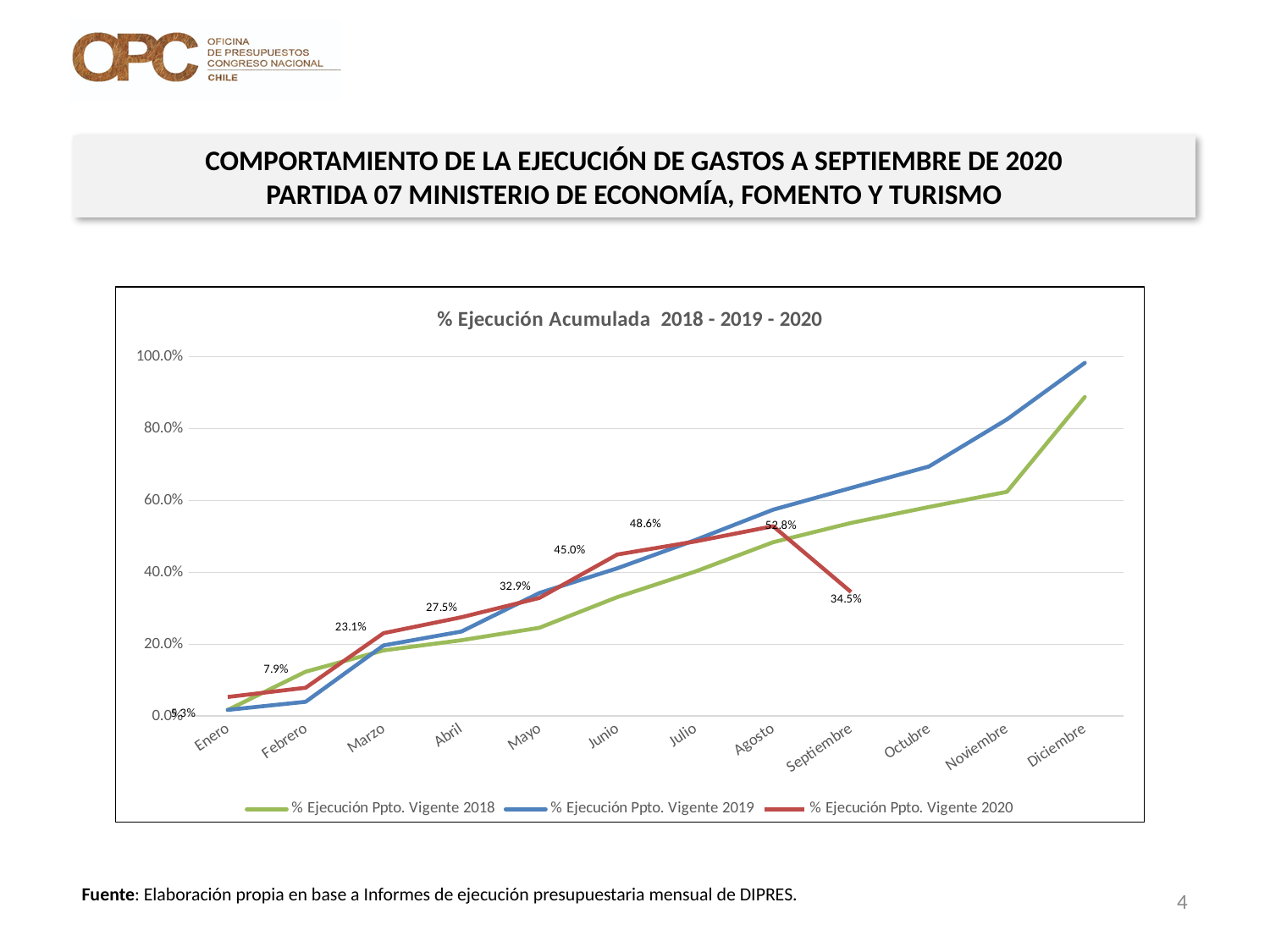
What is the difference between the Agosto and Julio values in the % Ejecución Ppto. Vigente 2020 series? 4.2% What is the value for Marzo in the % Ejecución Ppto. Vigente 2020 series? 23.1% In which month does the % Ejecución Ppto. Vigente 2020 series reach its highest value? Agosto What is the value for Septiembre in the % Ejecución Ppto. Vigente 2020 series? 34.5% Which series has the larger value in Diciembre, % Ejecución Ppto. Vigente 2018 or % Ejecución Ppto. Vigente 2019? % Ejecución Ppto. Vigente 2019 Is the Noviembre value for % Ejecución Ppto. Vigente 2018 greater or less than 80.0%? less What kind of chart is shown on the slide? Line chart How many series does the legend list? 3 What is the value for Junio in the % Ejecución Ppto. Vigente 2020 series? 45.0% What is the value for Agosto in the % Ejecución Ppto. Vigente 2020 series? 52.8% Is the Diciembre value for % Ejecución Ppto. Vigente 2019 greater or less than 80.0%? greater How many months are shown along the x axis? 12